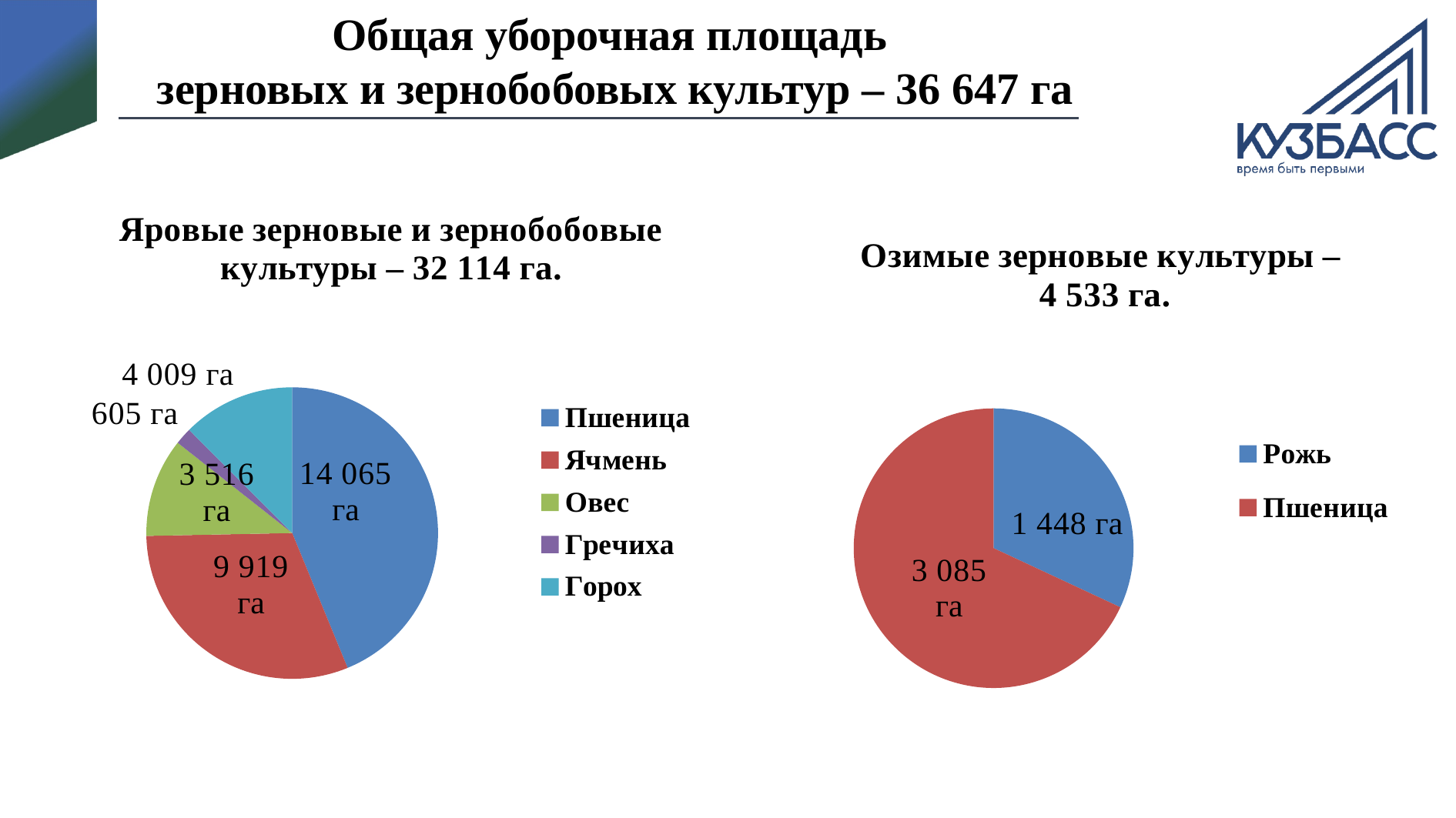
In the left pie chart (Яровые зерновые и зернобобовые культуры), what is the difference between Пшеница and Ячмень? 4 146 га In the left pie chart (Яровые зерновые и зернобобовые культуры), which category has the smallest area? Гречиха In the right pie chart (Озимые зерновые культуры), what is the difference between Пшеница and Рожь? 1 637 га In the right pie chart (Озимые зерновые культуры), what is the value for Пшеница? 3 085 га In the right pie chart (Озимые зерновые культуры), what is the value for Рожь? 1 448 га In the left pie chart (Яровые зерновые и зернобобовые культуры), what is the value for Гречиха? 605 га What type of chart is used on the right side of the slide (Озимые зерновые культуры)? Pie chart In the left pie chart (Яровые зерновые и зернобобовые культуры), which category has the largest area? Пшеница In the left pie chart (Яровые зерновые и зернобобовые культуры), which is larger, Горох or Овес? Горох How many entries does the legend of the right pie chart (Озимые зерновые культуры) list? 2 How many categories does the left pie chart (Яровые зерновые и зернобобовые культуры) show? 5 In the left pie chart (Яровые зерновые и зернобобовые культуры), what is the value for Пшеница? 14 065 га